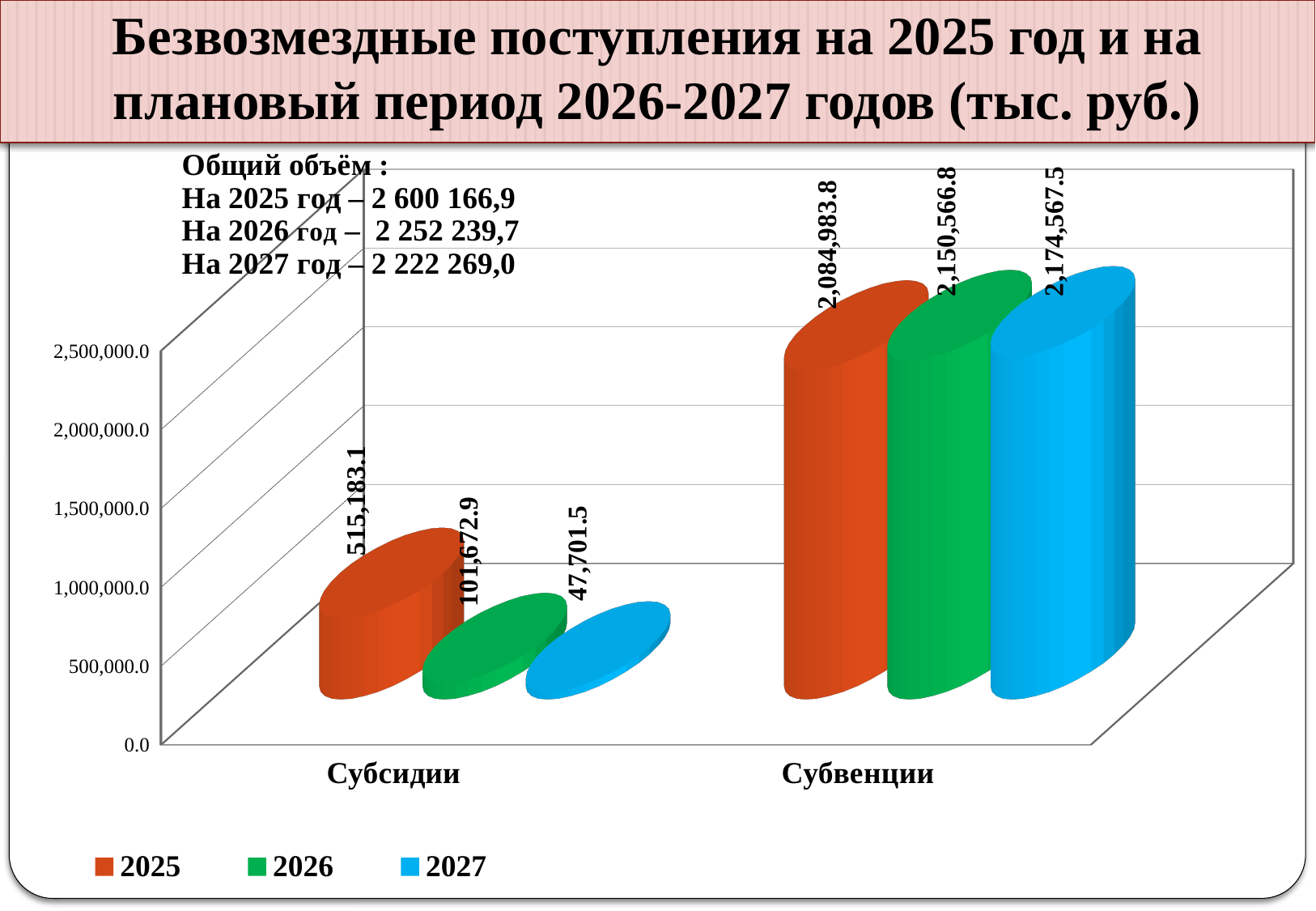
What is the value for Субсидии in 2025? 515,183.1 Which is larger: Субвенции in 2025 or Субвенции in 2026? Субвенции in 2026 What is the value for Субвенции in 2026? 2,150,566.8 What is the difference between the 2025 and 2026 values for Субсидии? 413,510.2 What is the value for Субвенции in 2027? 2,174,567.5 Do the values for Субсидии rise or fall from 2025 to 2027? Fall What is the value for Субсидии in 2027? 47,701.5 Which year has the highest value for Субвенции? 2027 How many categories are shown on the x axis? 2 How many series does the legend list? 3 What kind of chart is shown on the slide? Bar chart Which year has the lowest value for Субсидии? 2027